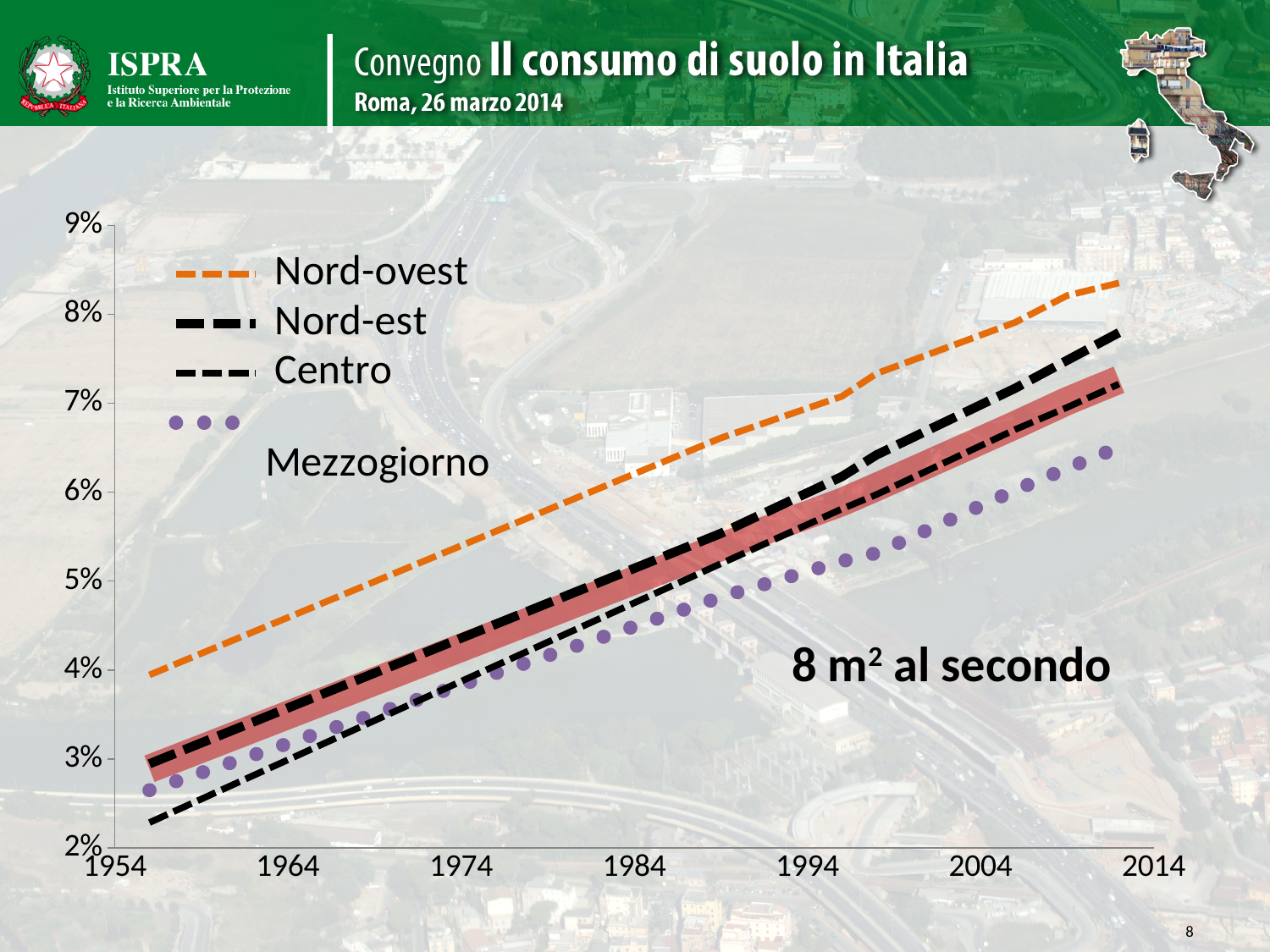
What kind of chart is shown on the slide? line chart Around 1994, which series has the larger value, Nord-ovest or Mezzogiorno? Nord-ovest Do the values of the Nord-ovest series rise or fall from 1954 to 2014? rise Which series is the highest across the whole period shown? Nord-ovest Which series is the lowest at the left end of the chart (around 1956)? Centro Is the value for Nord-est at the right end of the chart greater or less than 7%? greater Is the value for Nord-ovest at the right end of the chart greater or less than 8%? greater What colour is the Nord-ovest line in the chart? orange Is the value for Mezzogiorno at the right end of the chart greater or less than 6%? greater Which series is the lowest at the right end of the chart (around 2012)? Mezzogiorno How many series does the chart legend list? 4